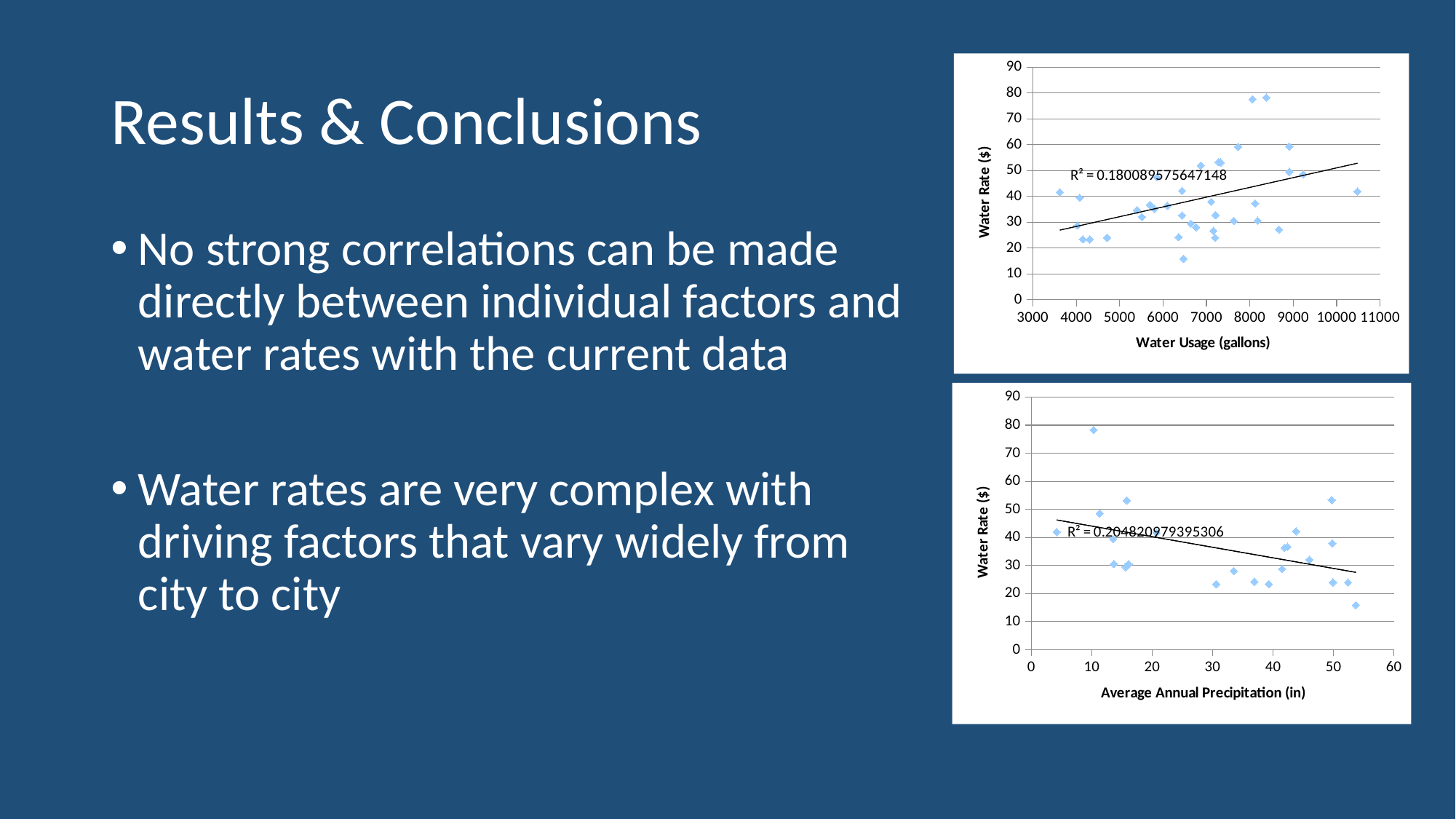
In the bottom chart, is the highest plotted water rate greater or less than 70? greater What is the x-axis title of the bottom chart? Average Annual Precipitation (in) What kind of chart is the bottom chart on the slide? scatter chart What kind of chart is the top chart on the slide? scatter chart In the bottom chart, is the lowest plotted water rate greater or less than 20? less What is the x-axis title of the top chart? Water Usage (gallons) In the top chart, is the highest plotted water rate greater or less than 70? greater In the bottom chart, what is the R² value printed next to the trendline? R² = 0.204820979395306 In the bottom chart, does the trendline rise or fall as average annual precipitation increases? fall In the top chart, what is the R² value printed next to the trendline? R² = 0.180089575647148 In the top chart, does the trendline rise or fall as water usage increases? rise